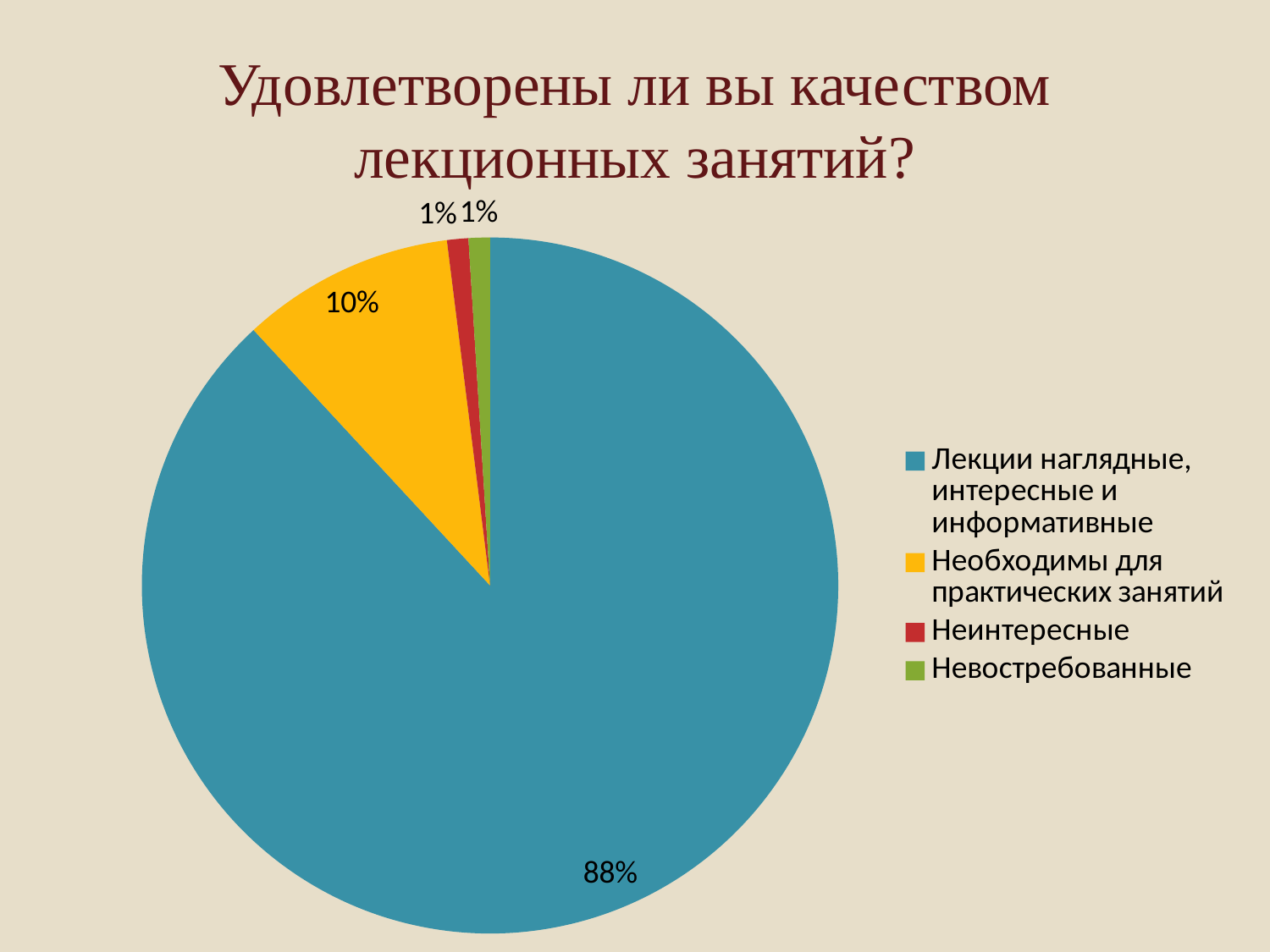
What colour is the slice for "Необходимы для практических занятий"? yellow Which category has the largest slice of the pie? Лекции наглядные, интересные и информативные What share of the pie is labelled "Неинтересные"? 1% What share of the pie is labelled "Лекции наглядные, интересные и информативные"? 88% How many categories does the legend list? 4 What is the difference in percentage points between the "Лекции наглядные, интересные и информативные" slice and the "Необходимы для практических занятий" slice? 78 What is the title of the chart? Удовлетворены ли вы качеством лекционных занятий? Which slice is larger: "Необходимы для практических занятий" or "Неинтересные"? Необходимы для практических занятий What kind of chart is shown on the slide? pie chart What share of the pie is labelled "Необходимы для практических занятий"? 10% What share of the pie is labelled "Невостребованные"? 1%